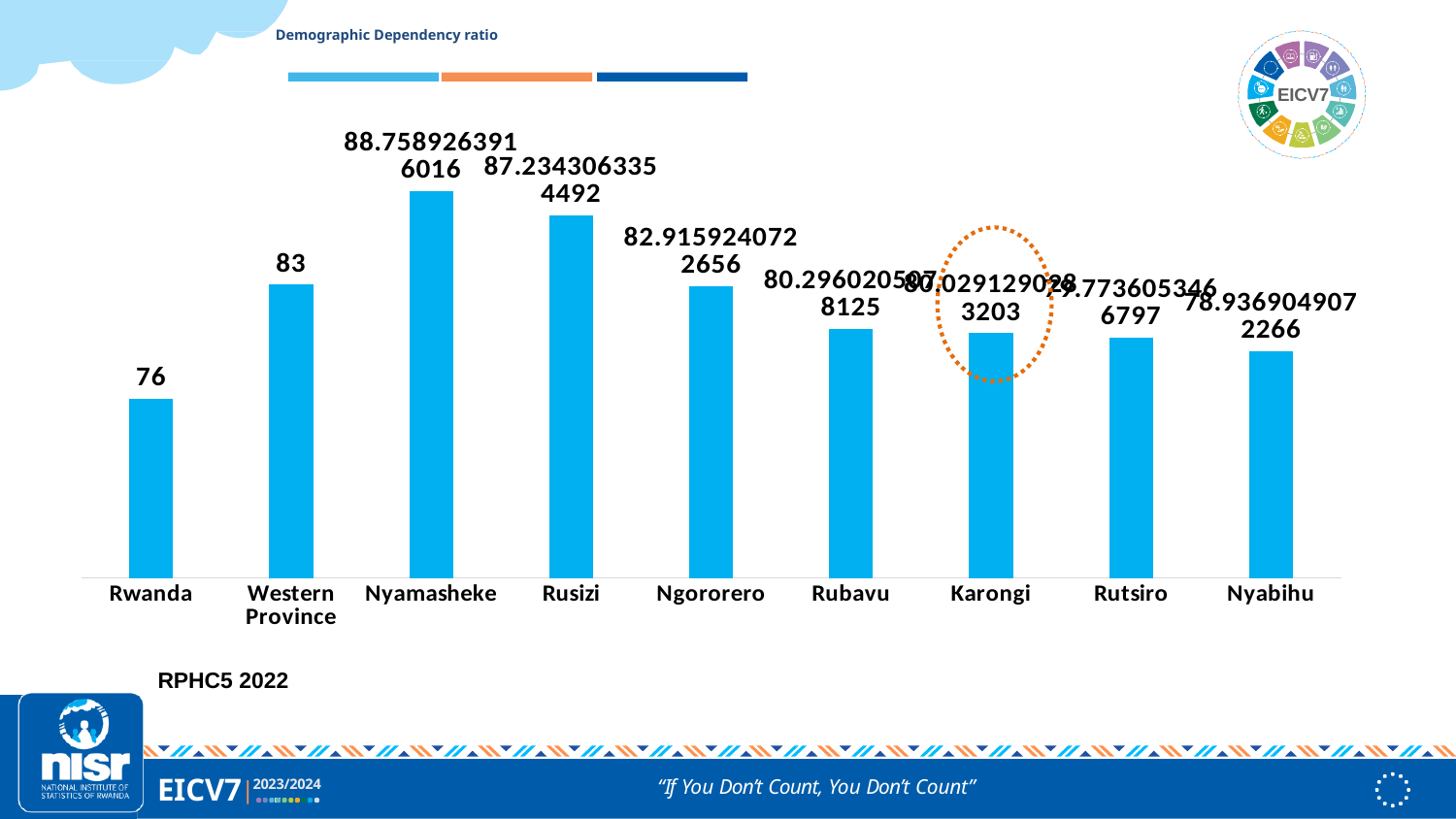
What type of chart is shown on the slide? bar chart What is the demographic dependency ratio for Rwanda? 76 What is the value shown for Nyamasheke? 88.7589263916016 Which district's bar is highlighted with a dotted orange circle? Karongi What is the value shown for Ngororero? 82.9159240722656 Which has a higher value, Rusizi or Ngororero? Rusizi What is the value shown for Rusizi? 87.2343063354492 What is the difference between the values for Western Province and Rwanda? 7 Which category has the highest demographic dependency ratio? Nyamasheke Which category has the lowest demographic dependency ratio? Rwanda How many categories are shown on the x axis? 9 What is the demographic dependency ratio for Western Province? 83